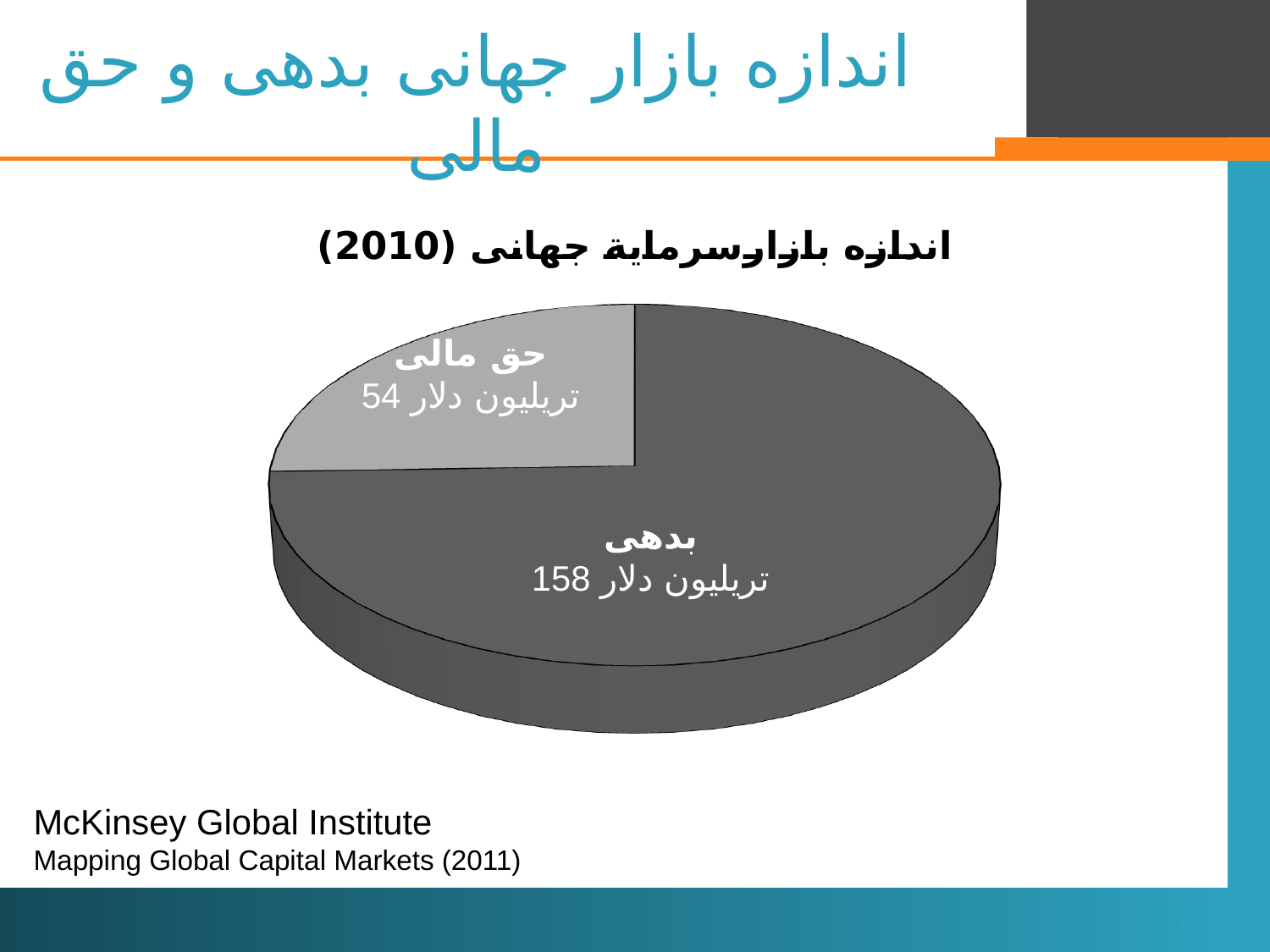
What kind of chart is shown on the slide? pie chart What is the value shown for the بدهی (debt) slice of the pie chart? 158 تریلیون دلار What source is cited below the chart? McKinsey Global Institute, Mapping Global Capital Markets (2011) What is the value shown for the حق مالی (equity) slice of the pie chart? 54 تریلیون دلار What is the combined total in trillion dollars of the two slices in the pie chart? 212 Which slice of the pie chart is the smallest? حق مالی Which is larger, the value for بدهی or the value for حق مالی? بدهی What is the title of the pie chart? اندازه بازارسرمایة جهانی (2010) What is the difference in trillion dollars between the بدهی slice and the حق مالی slice? 104 How many slices does the pie chart have? 2 Which slice of the pie chart is the largest? بدهی